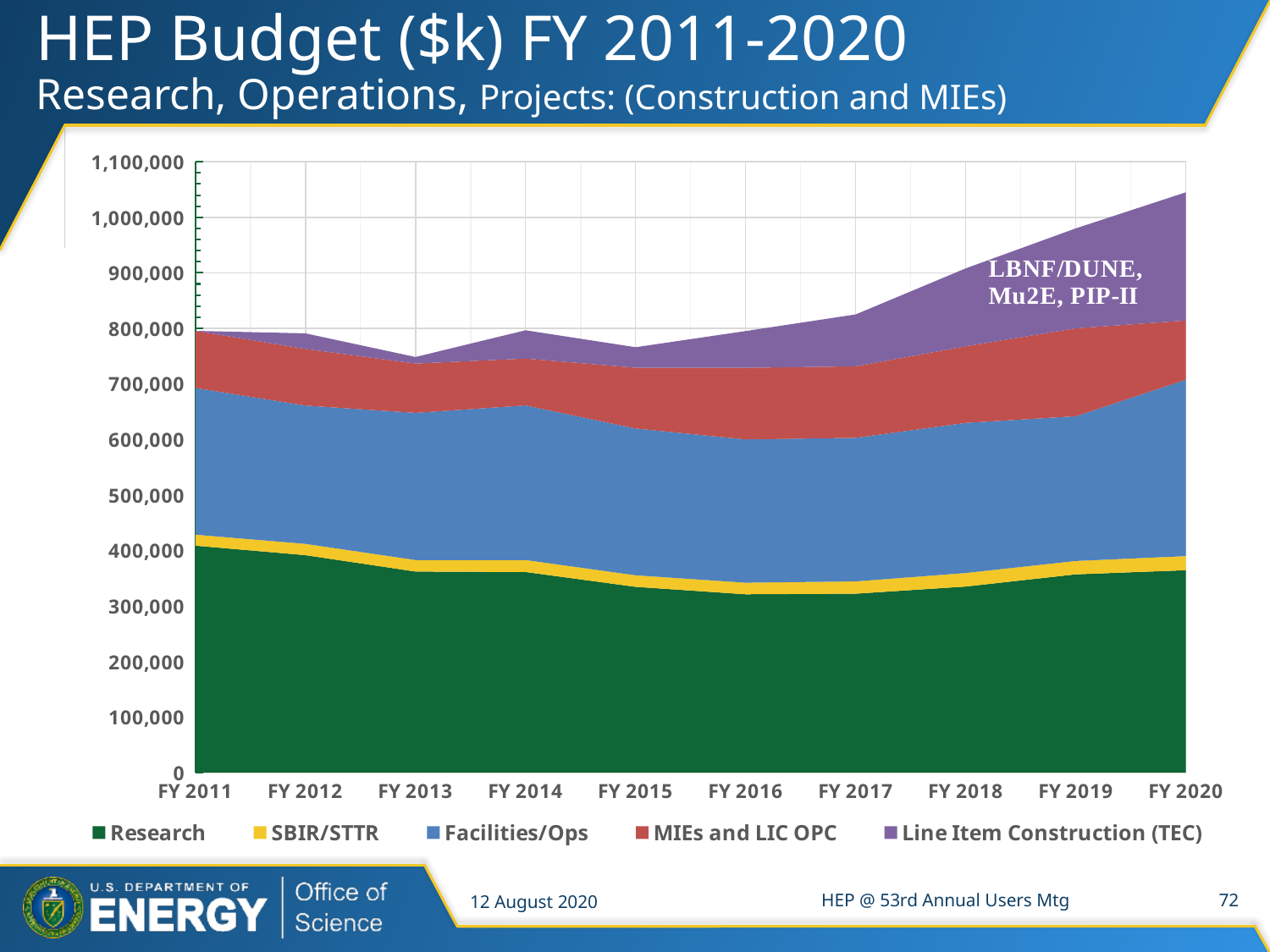
Does the total budget rise or fall from FY 2017 to FY 2020? Rise Is the Research value for FY 2016 greater or less than 400,000? less What projects are named in the annotation on the purple area? LBNF/DUNE, Mu2E, PIP-II How many series does the legend list? 5 Which is larger, the Research value in FY 2011 or in FY 2016? FY 2011 Is the total HEP budget for FY 2011 greater or less than 900,000? less Which fiscal year has the highest total budget? FY 2020 How many fiscal years are shown along the x axis? 10 Which is larger, the total budget in FY 2011 or in FY 2020? FY 2020 What kind of chart is shown on the slide? Stacked area chart Which series is plotted at the bottom of the stack? Research Is the total HEP budget for FY 2020 greater or less than 1,000,000? greater